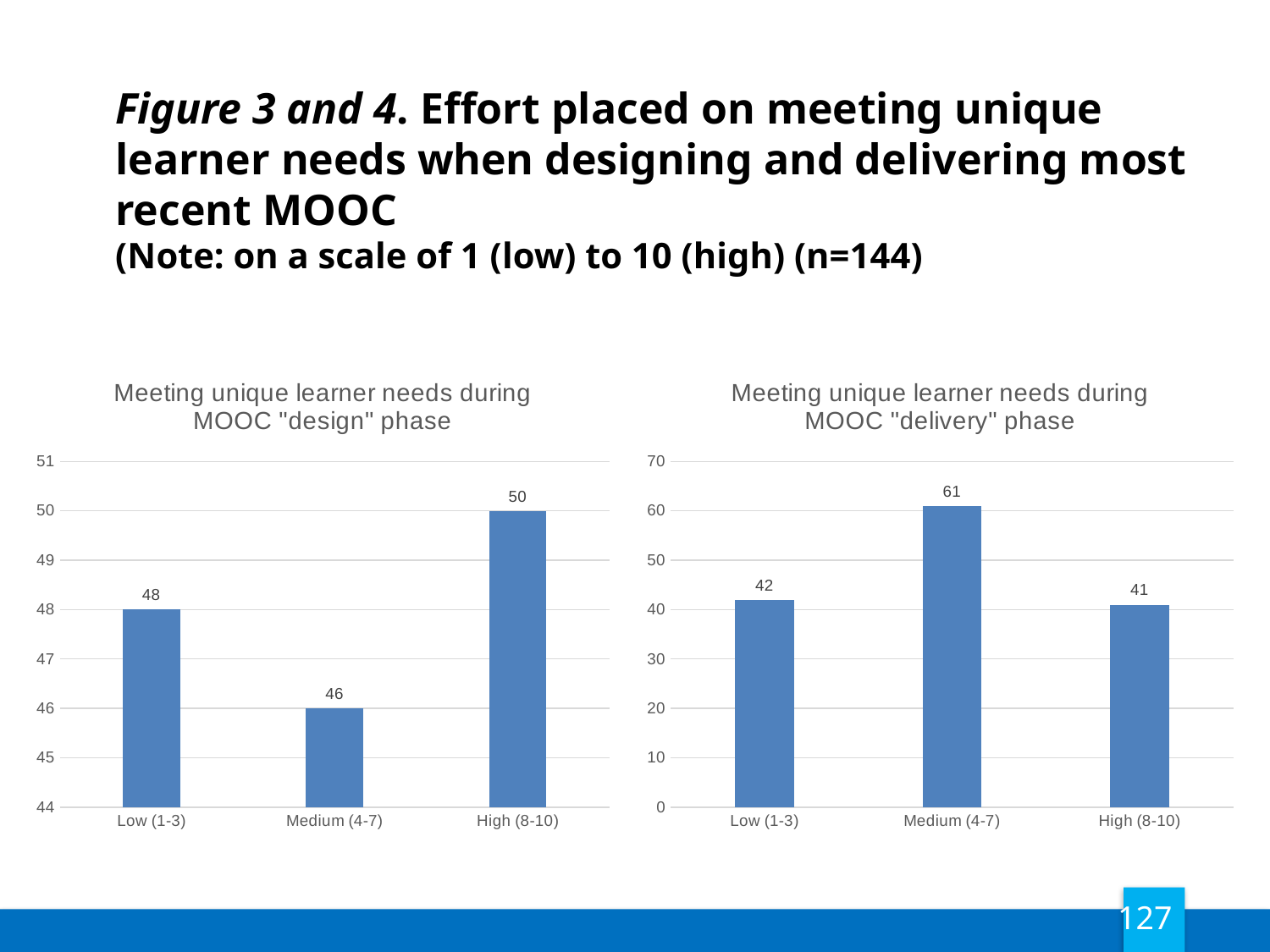
What type of chart is the "design" phase chart? Bar chart How many categories are shown in the "delivery" phase chart? 3 In the "delivery" phase chart, what is the value for High (8-10)? 41 In the "design" phase chart, what is the value for Low (1-3)? 48 In the "design" phase chart, which category has the highest value? High (8-10) In the "delivery" phase chart, what is the difference between Medium (4-7) and Low (1-3)? 19 In the "design" phase chart, what is the value for Medium (4-7)? 46 In the "design" phase chart, which is larger, Low (1-3) or Medium (4-7)? Low (1-3) In the "delivery" phase chart, what is the value for Medium (4-7)? 61 In the "design" phase chart, what is the difference between High (8-10) and Medium (4-7)? 4 What is the title of the chart on the right side of the slide? Meeting unique learner needs during MOOC "delivery" phase In the "delivery" phase chart, which category has the lowest value? High (8-10)